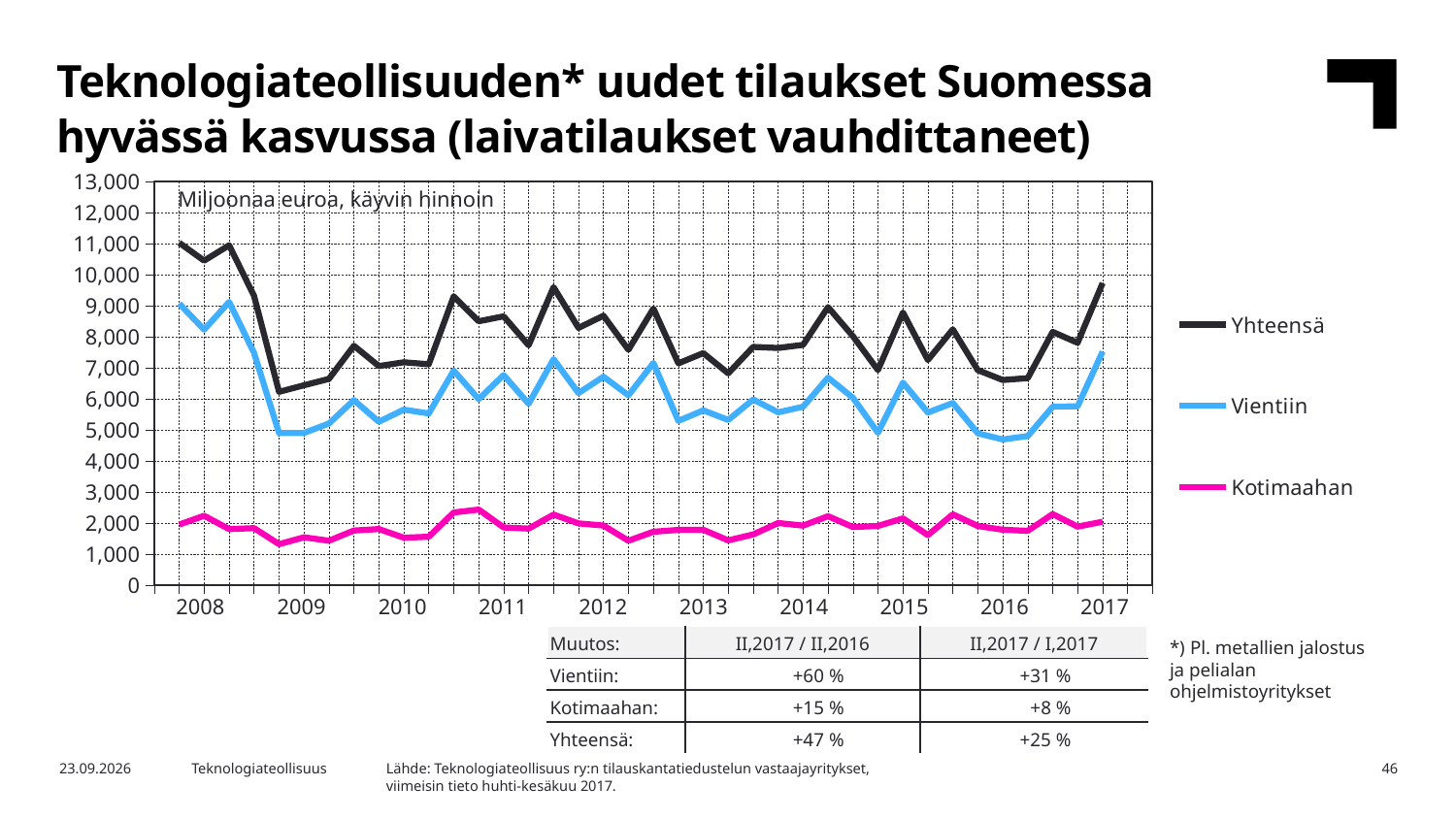
Which series is shown in pink (magenta) in the chart? Kotimaahan Which series has the highest values throughout the chart? Yhteensä Is the value for Yhteensä at the start of 2008 greater or less than 10,000? greater How many years are labelled on the x axis of the chart? 10 Does the Yhteensä line rise or fall from the start of 2008 to the start of 2009? fall What kind of chart is shown on the slide? line chart What unit label is printed inside the chart area? Miljoonaa euroa, käyvin hinnoin Does the Vientiin line rise or fall from the start of 2016 to the last point in 2017? rise Is the value for Vientiin at the last point in 2017 greater or less than 6,000? greater Is the value for Kotimaahan at the start of 2008 greater or less than 3,000? less How many series does the chart legend list? 3 Which series has the lowest values throughout the chart? Kotimaahan